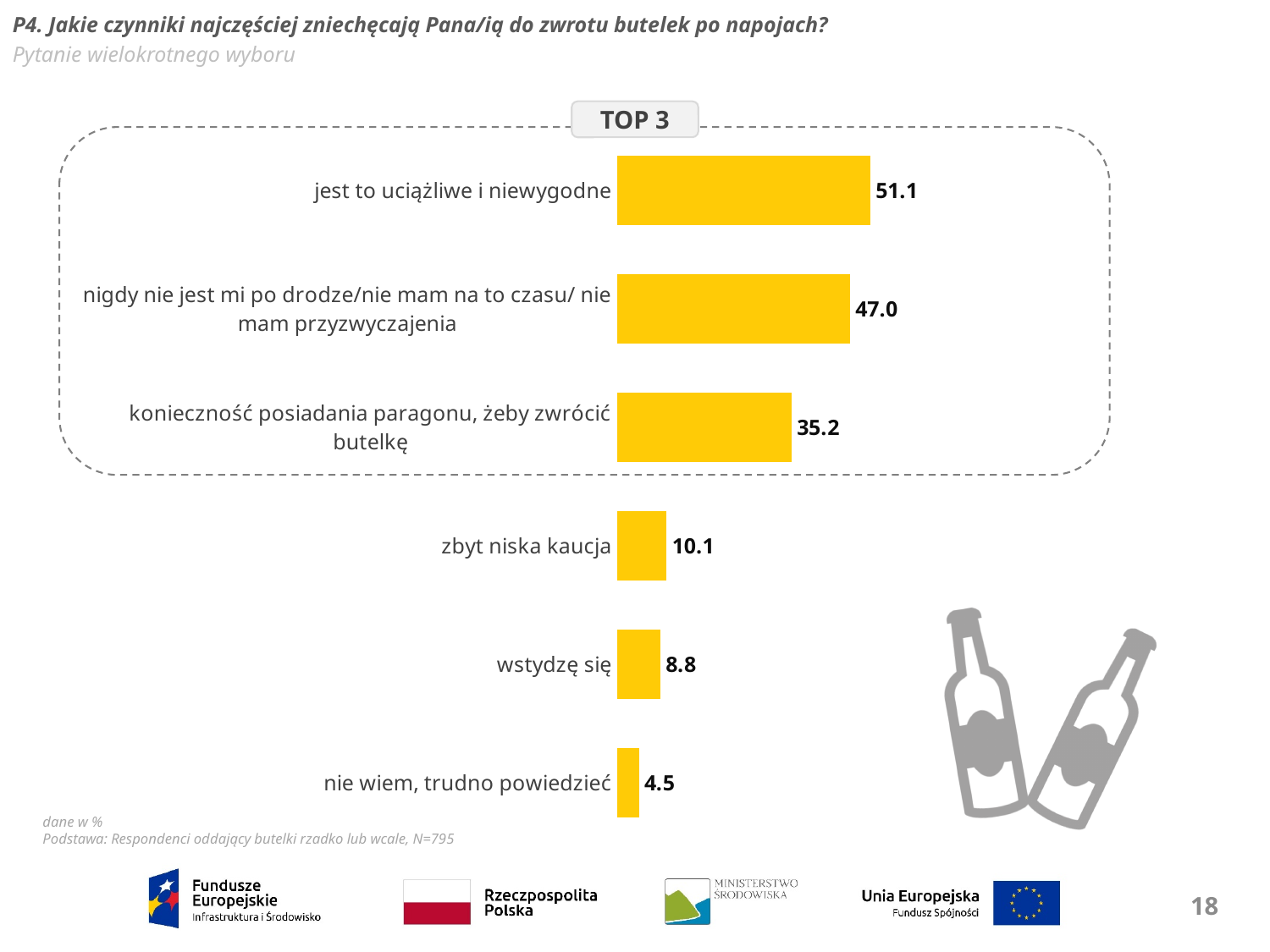
Which is larger: the value for "konieczność posiadania paragonu, żeby zwrócić butelkę" or the value for "zbyt niska kaucja"? konieczność posiadania paragonu, żeby zwrócić butelkę What is the value for "nie wiem, trudno powiedzieć"? 4.5 What is the difference between the values for "zbyt niska kaucja" and "wstydzę się"? 1.3 What is the value for "konieczność posiadania paragonu, żeby zwrócić butelkę"? 35.2 Which category has the highest value? jest to uciążliwe i niewygodne What is the value for "jest to uciążliwe i niewygodne"? 51.1 What is the difference between the values for "jest to uciążliwe i niewygodne" and "nigdy nie jest mi po drodze/nie mam na to czasu/ nie mam przyzwyczajenia"? 4.1 How many categories are shown in the chart? 6 What kind of chart is shown on the slide? bar chart How many categories are enclosed in the dashed box labelled "TOP 3"? 3 What is the value for "zbyt niska kaucja"? 10.1 Which category has the lowest value? nie wiem, trudno powiedzieć